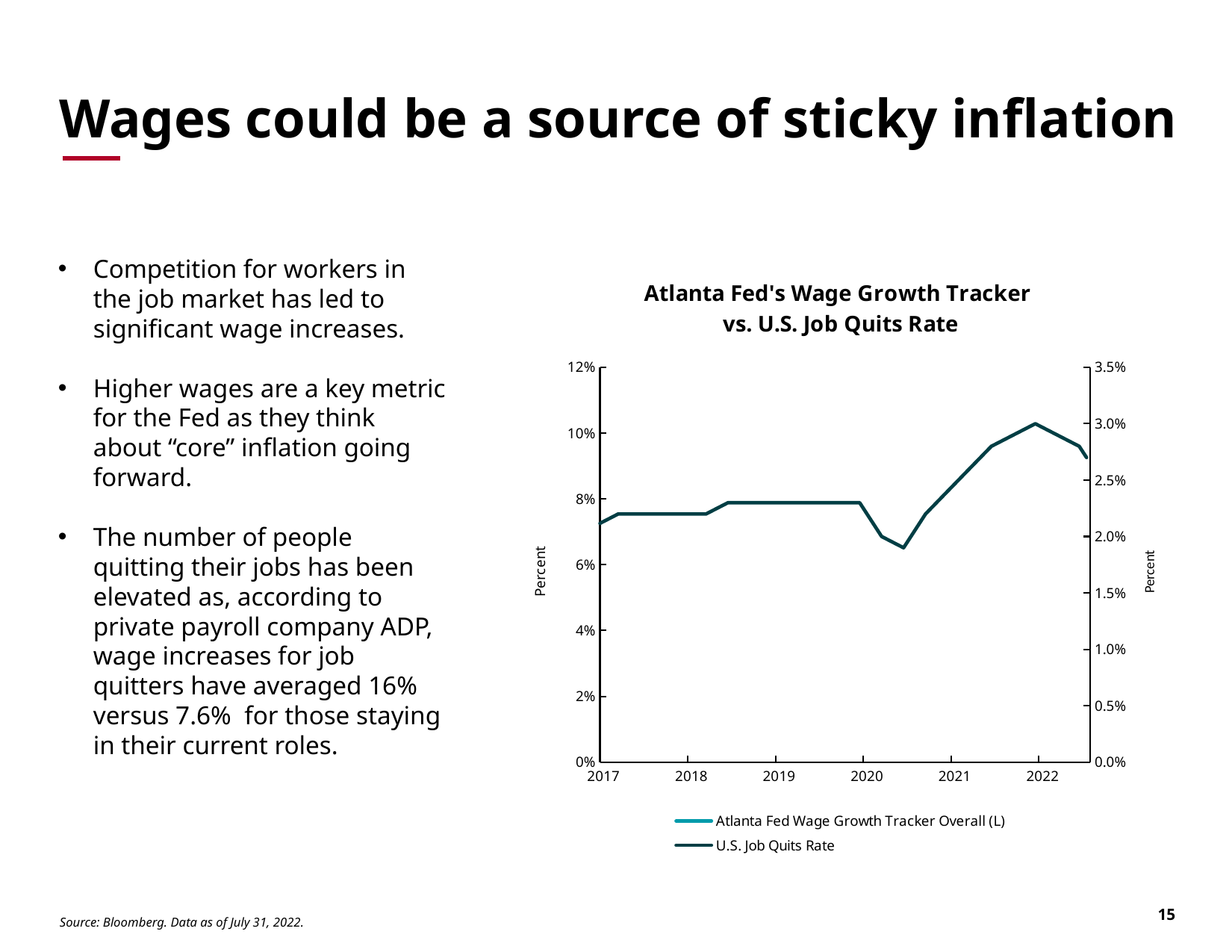
What is the highest value shown on the right-hand y axis? 3.5% Is the peak value of the U.S. Job Quits Rate line greater or less than 2.5% on the right axis? greater How many year labels are shown on the x axis of the chart? 6 Does the U.S. Job Quits Rate line rise or fall between its 2020 low and its 2022 peak? rise Around which year does the U.S. Job Quits Rate line reach its highest point? 2022 Is the value of the U.S. Job Quits Rate line at the start of 2017 greater or less than 2.5% on the right axis? less What is the title of the chart? Atlanta Fed's Wage Growth Tracker vs. U.S. Job Quits Rate Around which year does the U.S. Job Quits Rate line reach its lowest point? 2020 How many series does the chart's legend list? 2 What kind of chart is shown on the slide? line chart Is the U.S. Job Quits Rate value at the 2022 peak larger or smaller than the value at the start of 2017? larger Is the value of the U.S. Job Quits Rate line at the start of 2017 greater or less than 1.5% on the right axis? greater